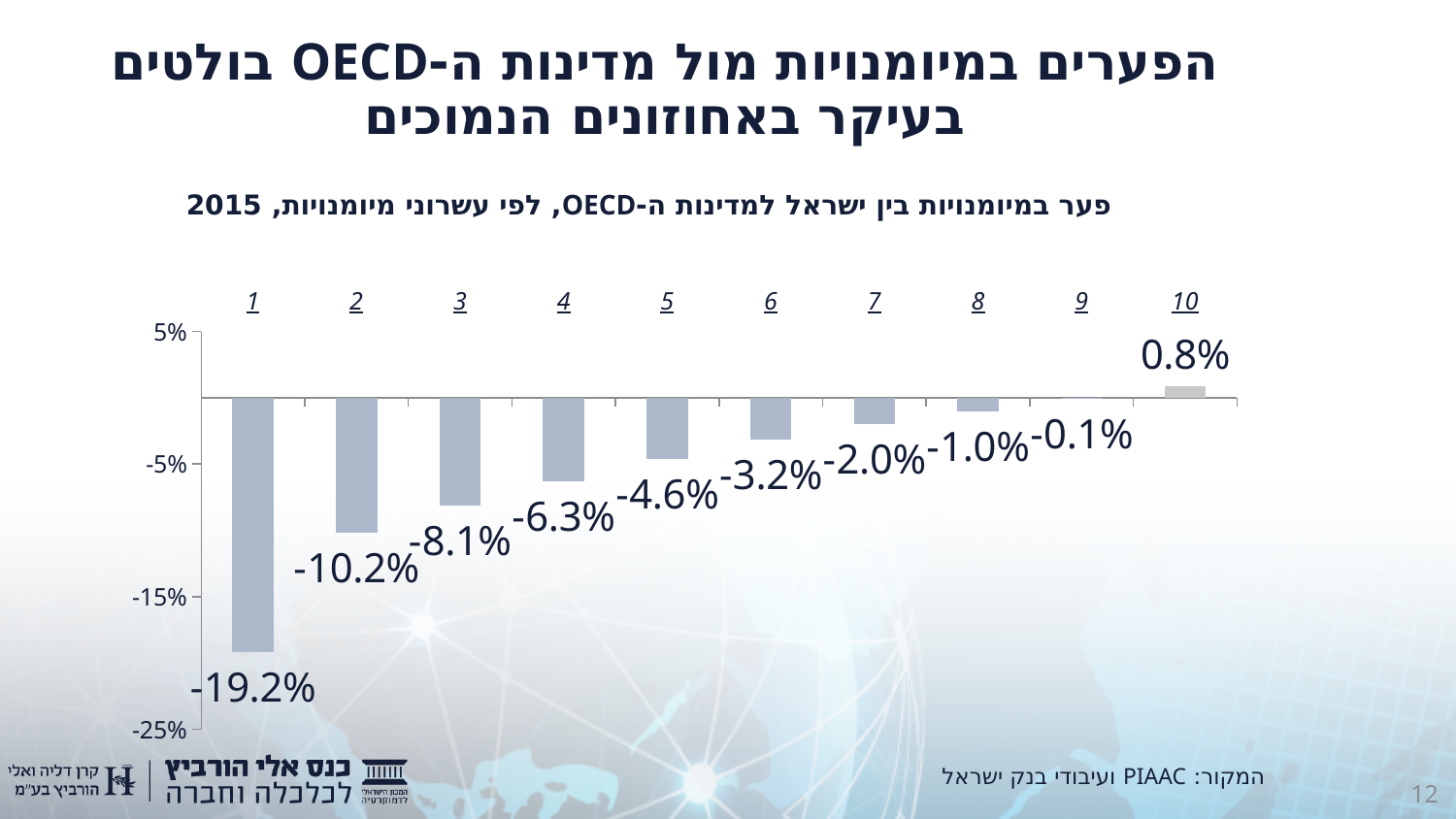
Which decile has the highest value? 10 What is the value for decile 1? -19.2% Is the value for decile 1 greater or less than -15%? less What is the difference between the values for decile 2 and decile 3? 2.1 percentage points Do the values rise or fall from decile 1 to decile 10? rise Which decile has the lowest value? 1 Which is larger, the value for decile 4 or the value for decile 6? decile 6 What is the value for decile 10? 0.8% What is the value for decile 9? -0.1% What is the value for decile 5? -4.6% What kind of chart is shown on the slide? bar chart How many deciles are shown on the x axis? 10